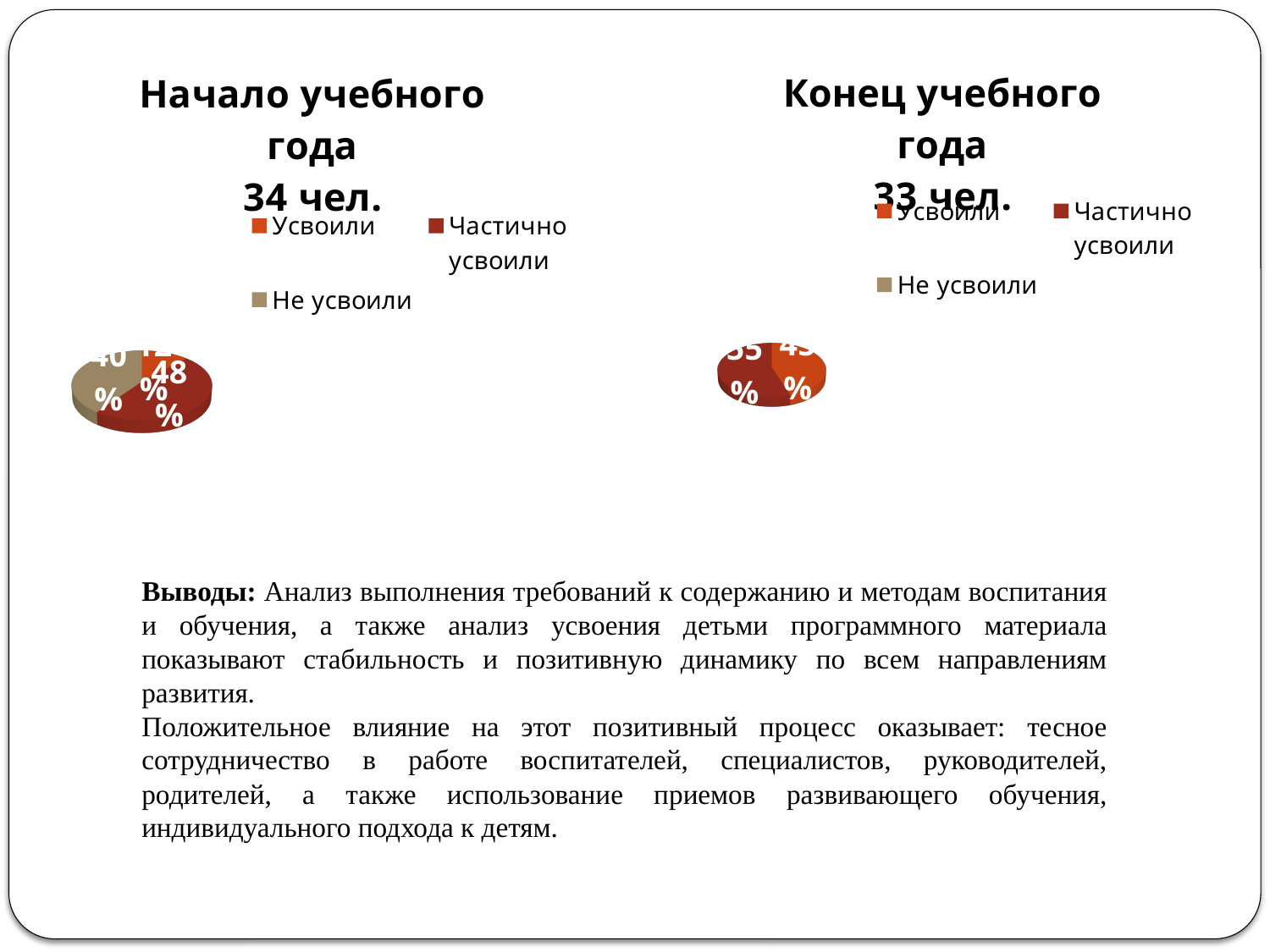
In the 'Начало учебного года' chart, what is the difference between 'Частично усвоили' and 'Не усвоили'? 8 percentage points What kind of chart is used on this slide for both 'Начало учебного года' and 'Конец учебного года'? Pie chart In the 'Начало учебного года' chart, what percentage is shown for 'Частично усвоили'? 48% In the 'Конец учебного года' chart, what percentage is shown for 'Усвоили'? 45% In the 'Начало учебного года' chart, which category has the largest slice? Частично усвоили In the 'Конец учебного года' chart, which category has the largest slice? Частично усвоили In the 'Конец учебного года' chart, what percentage is shown for 'Частично усвоили'? 55% How many entries does the legend of the 'Начало учебного года' chart list? 3 In the 'Начало учебного года' chart, what percentage is shown for 'Не усвоили'? 40% In the 'Конец учебного года' chart, what is the difference between 'Частично усвоили' and 'Усвоили'? 10 percentage points How many people does the title of the 'Конец учебного года' chart say were assessed? 33 чел. In the 'Начало учебного года' chart, which is larger: 'Частично усвоили' or 'Не усвоили'? Частично усвоили